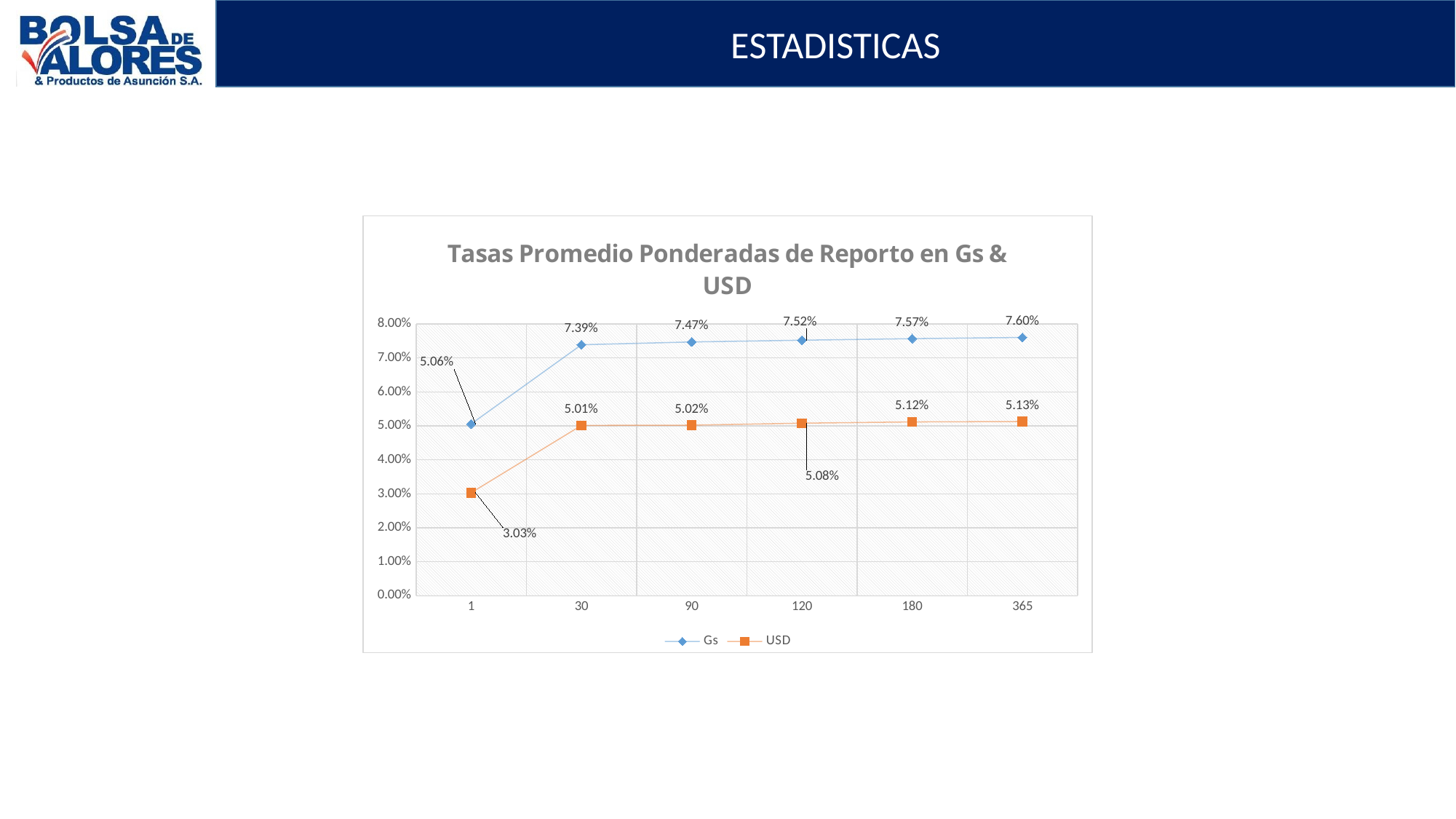
How many series does the legend list? 2 At which x-axis category is the Gs series highest? 365 Do the USD values rise or fall from 1 to 365? Rise What is the USD value at 1? 3.03% Which is larger at 90, the Gs value or the USD value? Gs What is the difference between the Gs value and the USD value at 180? 2.45% What is the USD value at 120? 5.08% What is the Gs value at 365? 7.60% What kind of chart is shown? Line chart How many x-axis categories are plotted? 6 At which x-axis category is the USD series lowest? 1 What is the Gs value at 30? 7.39%